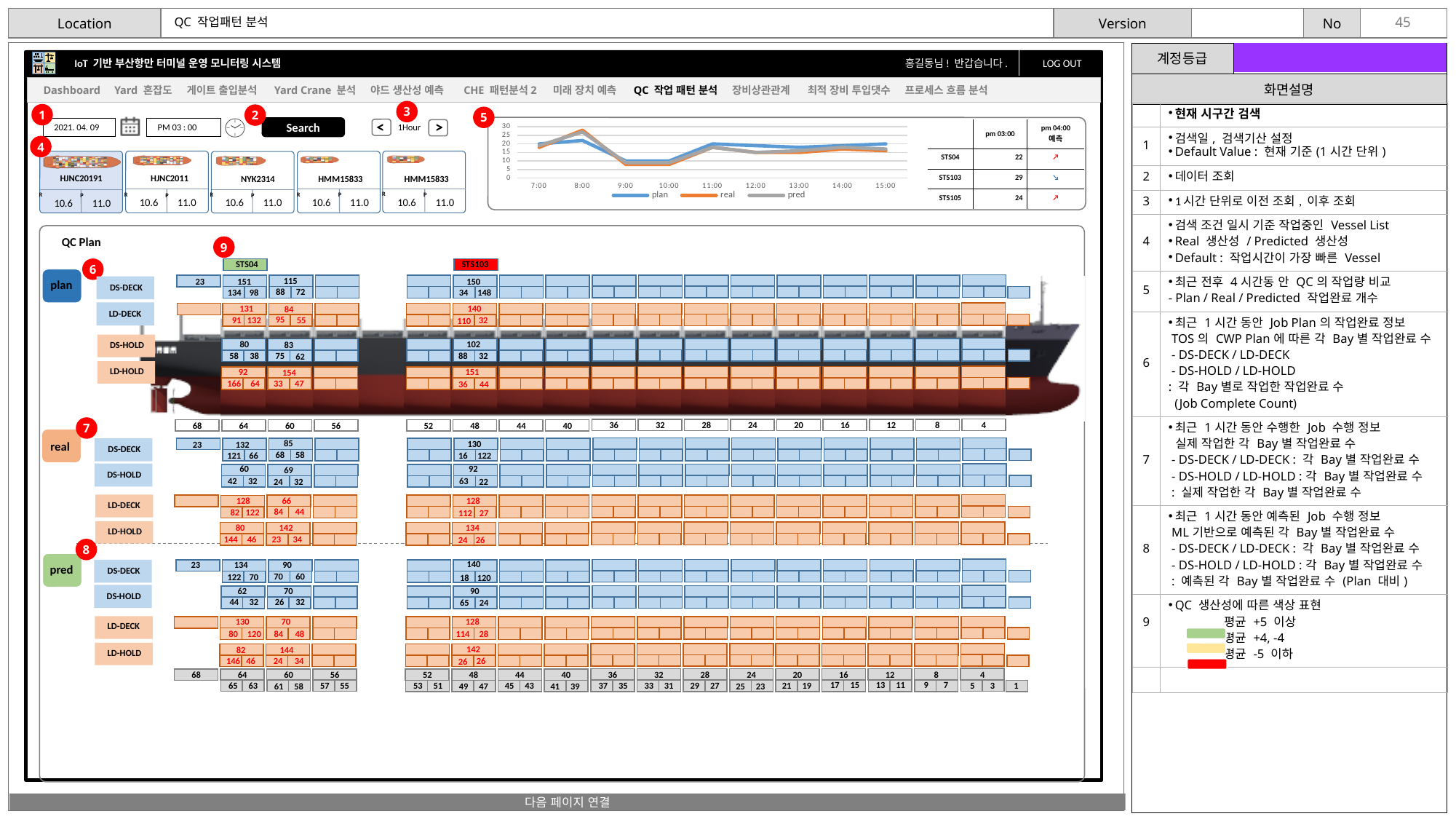
In the line chart in the top panel, is the value of the plan series at 9:00 greater or less than 15? less How many time labels are shown on the x axis of the line chart in the top panel? 9 In the line chart in the top panel, do the series values rise or fall between 8:00 and 9:00? fall In the line chart in the top panel, which is larger: the real value at 8:00 or the real value at 9:00? 8:00 What kind of chart is shown in the top panel labelled 5 (the chart with the plan, real and pred legend)? line chart In the line chart in the top panel, is the value of the real series at 10:00 greater or less than 15? less In the line chart in the top panel, is the value of the real series at 8:00 greater or less than 20? greater In the line chart in the top panel, at which time does the real series reach its highest value? 8:00 What colour is used for the real series in the line chart in the top panel? orange What are the three series named in the legend of the line chart in the top panel? plan, real, pred How many series does the legend of the line chart in the top panel list? 3